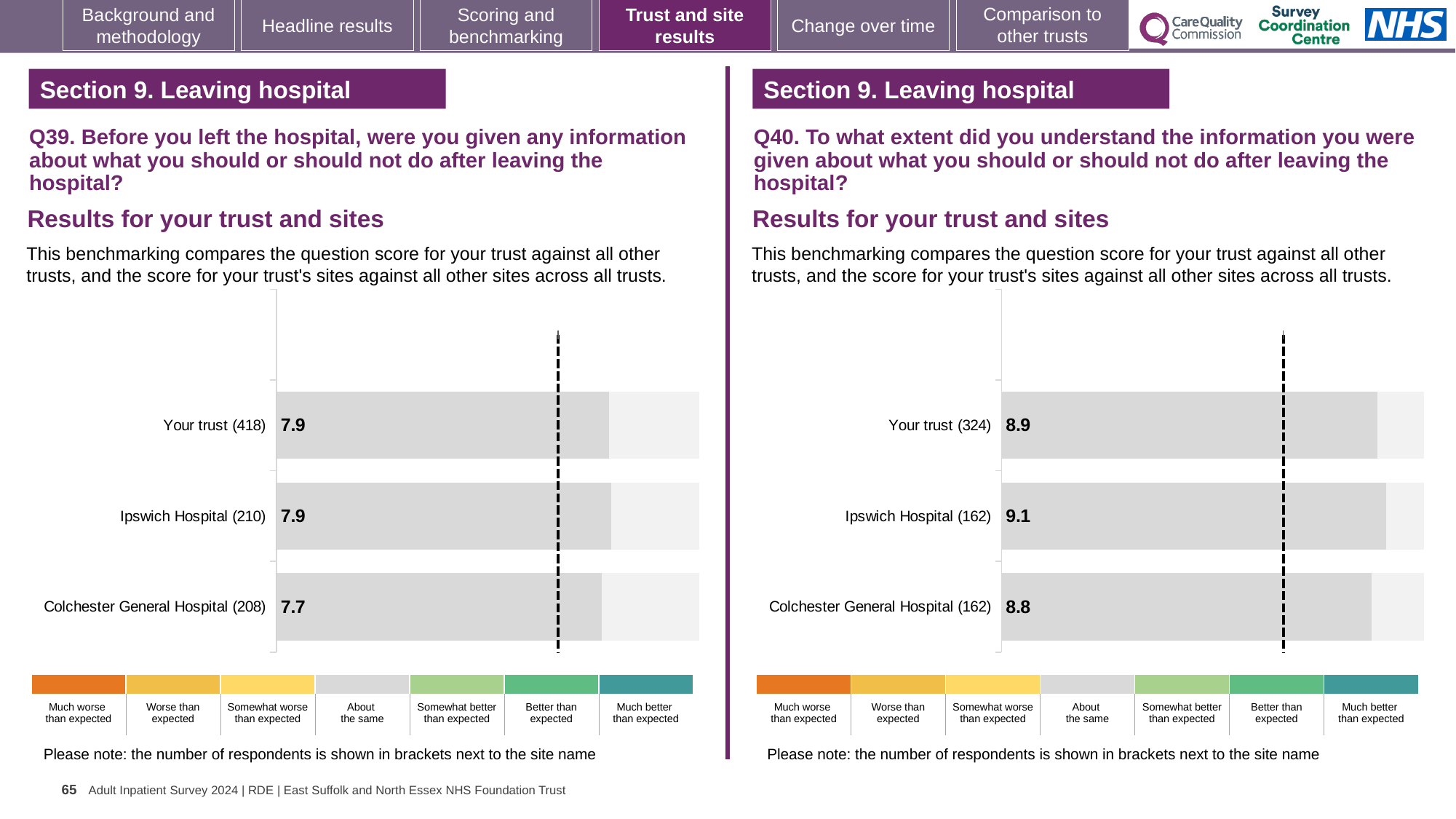
In the Q39 chart on the left, which site or trust has the lowest score? Colchester General Hospital In the Q40 chart on the right, what is the score for Colchester General Hospital? 8.8 How many bars are plotted in the Q39 chart on the left? 3 In the Q40 chart on the right, what is the difference between the scores for Ipswich Hospital and Colchester General Hospital? 0.3 In the Q40 chart on the right, which has the larger score, Your trust or Colchester General Hospital? Your trust In the Q40 chart on the right, what is the score for Ipswich Hospital? 9.1 In the Q39 chart on the left, what is the score for Colchester General Hospital? 7.7 In the Q39 chart on the left, how many respondents are shown in brackets for Ipswich Hospital? 210 What kind of chart is used for the Q40 results on the right? Bar chart In the Q39 chart on the left, what is the score for Your trust? 7.9 In the Q40 chart on the right, which site or trust has the highest score? Ipswich Hospital In the Q39 chart on the left, what is the difference between the scores for Your trust and Colchester General Hospital? 0.2